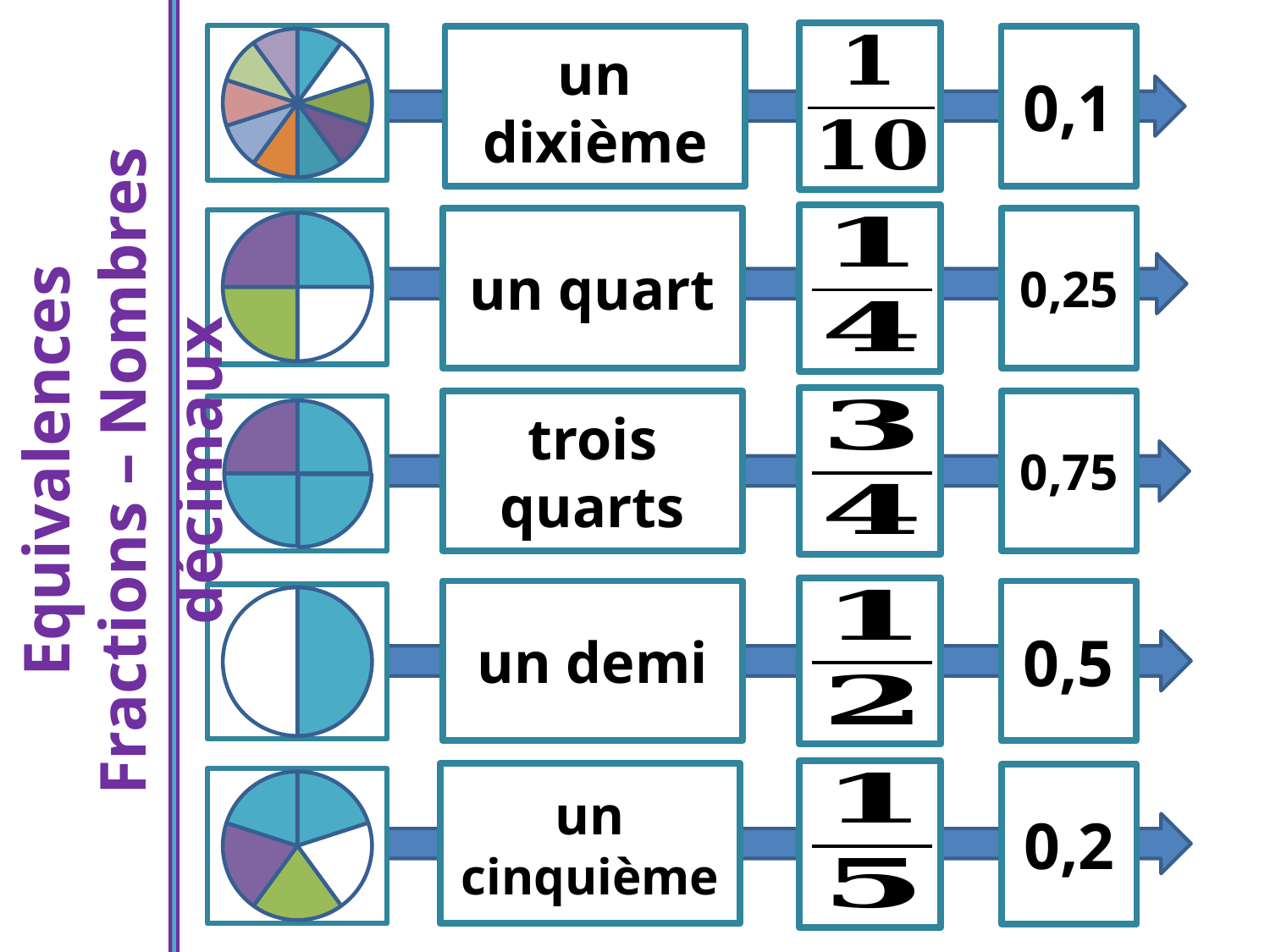
How many pie charts are shown on the slide? 5 Which row's pie chart is divided into the most slices? un dixième What decimal value is shown in the row labelled "un quart"? 0,25 How many slices does the pie chart in the row labelled "un cinquième" have? 5 Which decimal value is larger, the one for "un quart" or the one for "un demi"? un demi How many slices does the pie chart in the row labelled "un quart" have? 4 What kind of chart is shown in the row labelled "un dixième"? pie chart Which row's pie chart is divided into the fewest slices? un demi What decimal value is shown in the row labelled "un cinquième"? 0,2 What fraction is shown in the row labelled "trois quarts"? 3/4